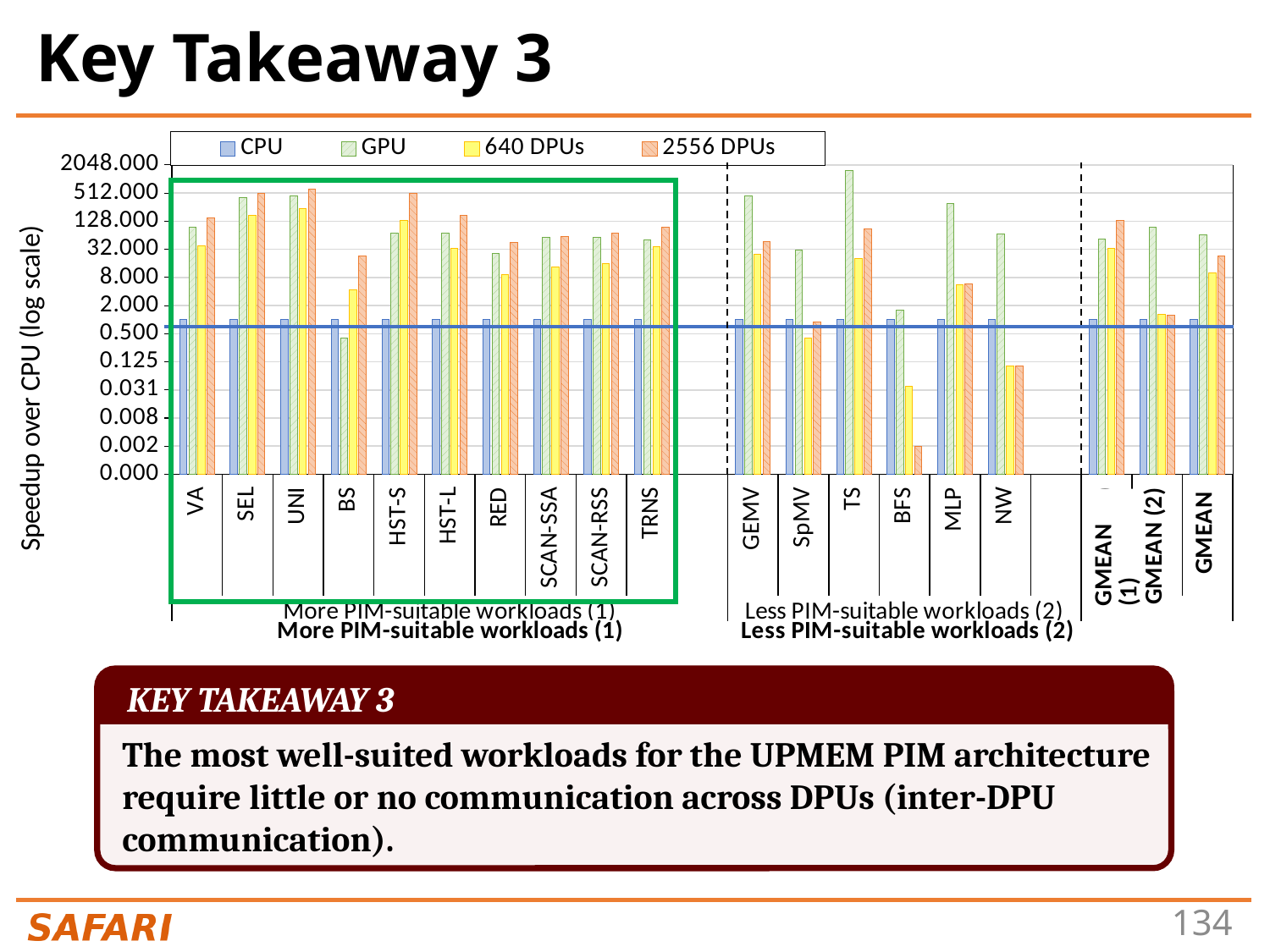
For BS, which is larger: the GPU value or the 2556 DPUs value? 2556 DPUs How many workload categories (including the GMEAN entries) are shown along the x axis? 19 Is the GPU value for GEMV greater or less than 128? greater Which series has the highest value for TS? GPU Is the GPU value for TS greater or less than 512? greater What kind of chart is shown on the slide? bar chart Is the 2556 DPUs value for BFS greater or less than 0.008? less For which workload is the 2556 DPUs bar the lowest? BFS What is the label of the y axis of the chart? Speedup over CPU (log scale) How many series does the chart's legend list? 4 Which series are listed in the chart's legend? CPU, GPU, 640 DPUs, 2556 DPUs